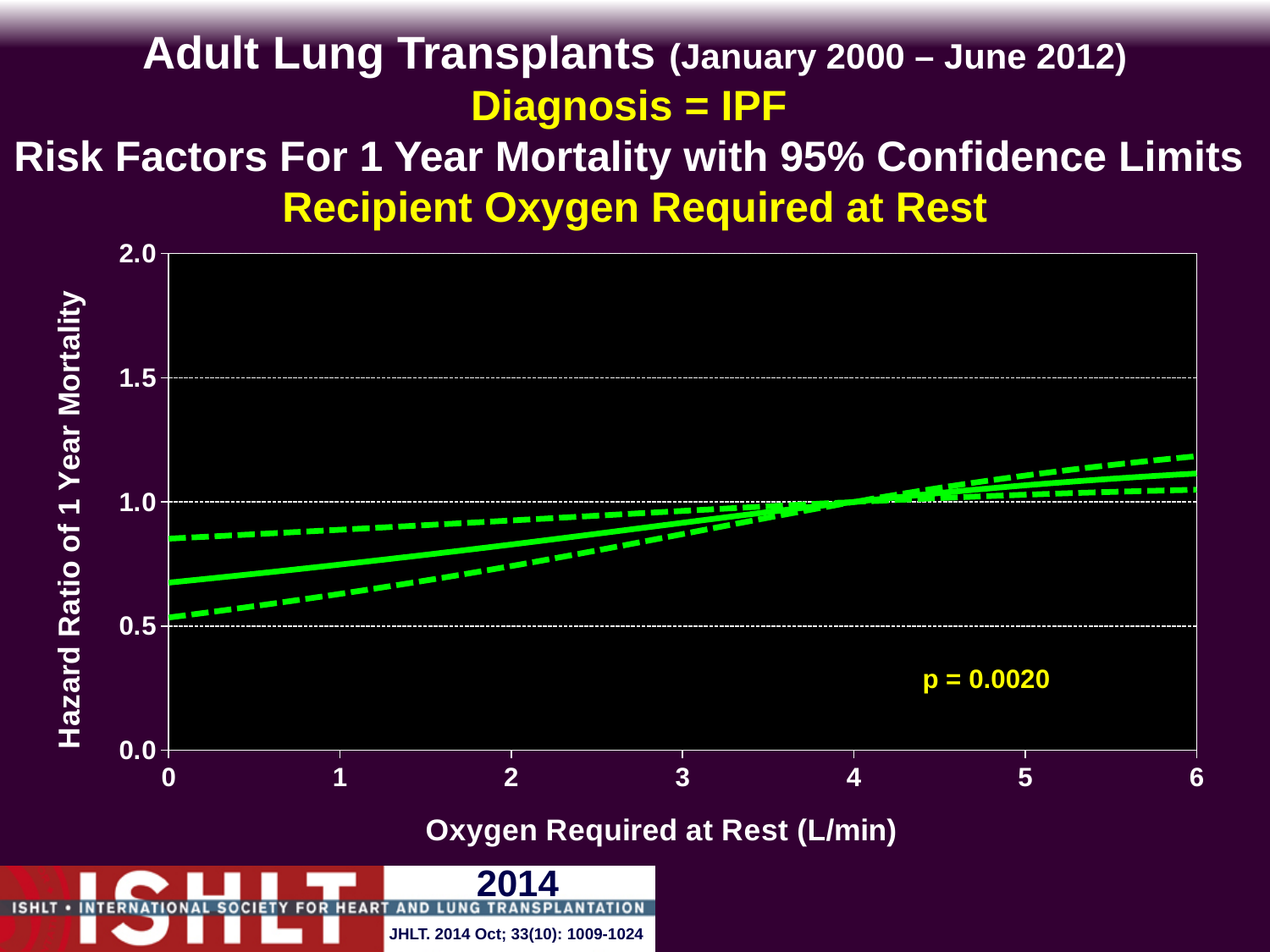
What is the p-value shown on the chart? p = 0.0020 Does the solid hazard ratio line rise or fall as oxygen required at rest increases from 0 to 6 L/min? Rises What is the maximum value shown on the y axis? 2.0 Is the hazard ratio (solid line) at 0 L/min greater or less than 1.0? less Is the hazard ratio (solid line) at 6 L/min greater or less than 1.0? greater What kind of chart is shown on the slide? Line chart Is the upper confidence limit (upper dashed line) at 0 L/min greater or less than 1.0? less What is the label of the y axis? Hazard Ratio of 1 Year Mortality How many lines are plotted on the chart? 3 What is the label of the x axis? Oxygen Required at Rest (L/min)